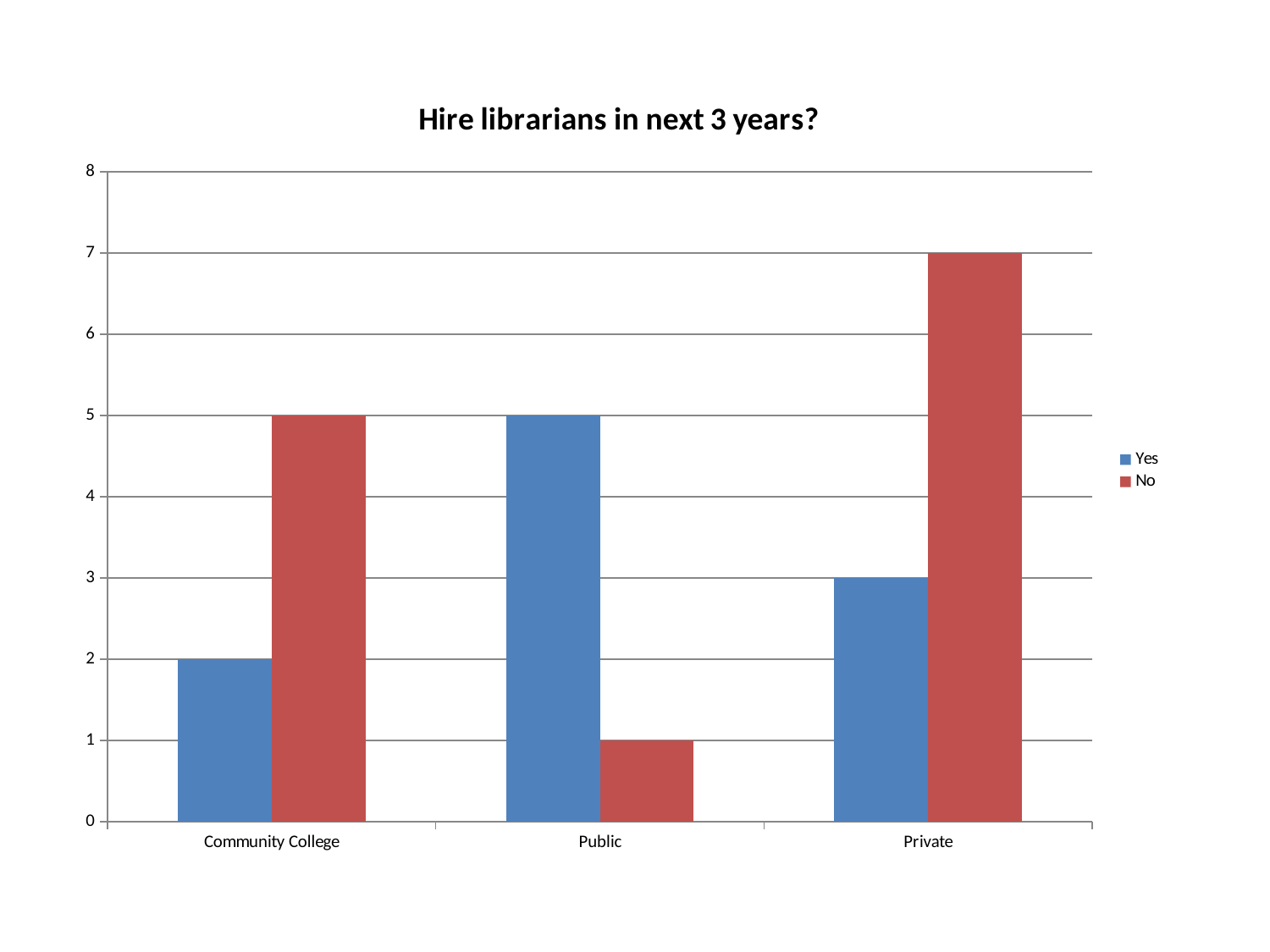
What is the difference between the No and Yes values for Private? 4 How many series does the legend list? 2 What is the value for No for Public? 1 Which is larger for Public, Yes or No? Yes What is the value for Yes for Community College? 2 How many categories are shown on the x axis? 3 What kind of chart is shown? Bar chart What is the title of the chart? Hire librarians in next 3 years? Is the No value for Community College greater or less than 4? greater What is the value for No for Private? 7 Which category has the highest No value? Private Which category has the lowest Yes value? Community College